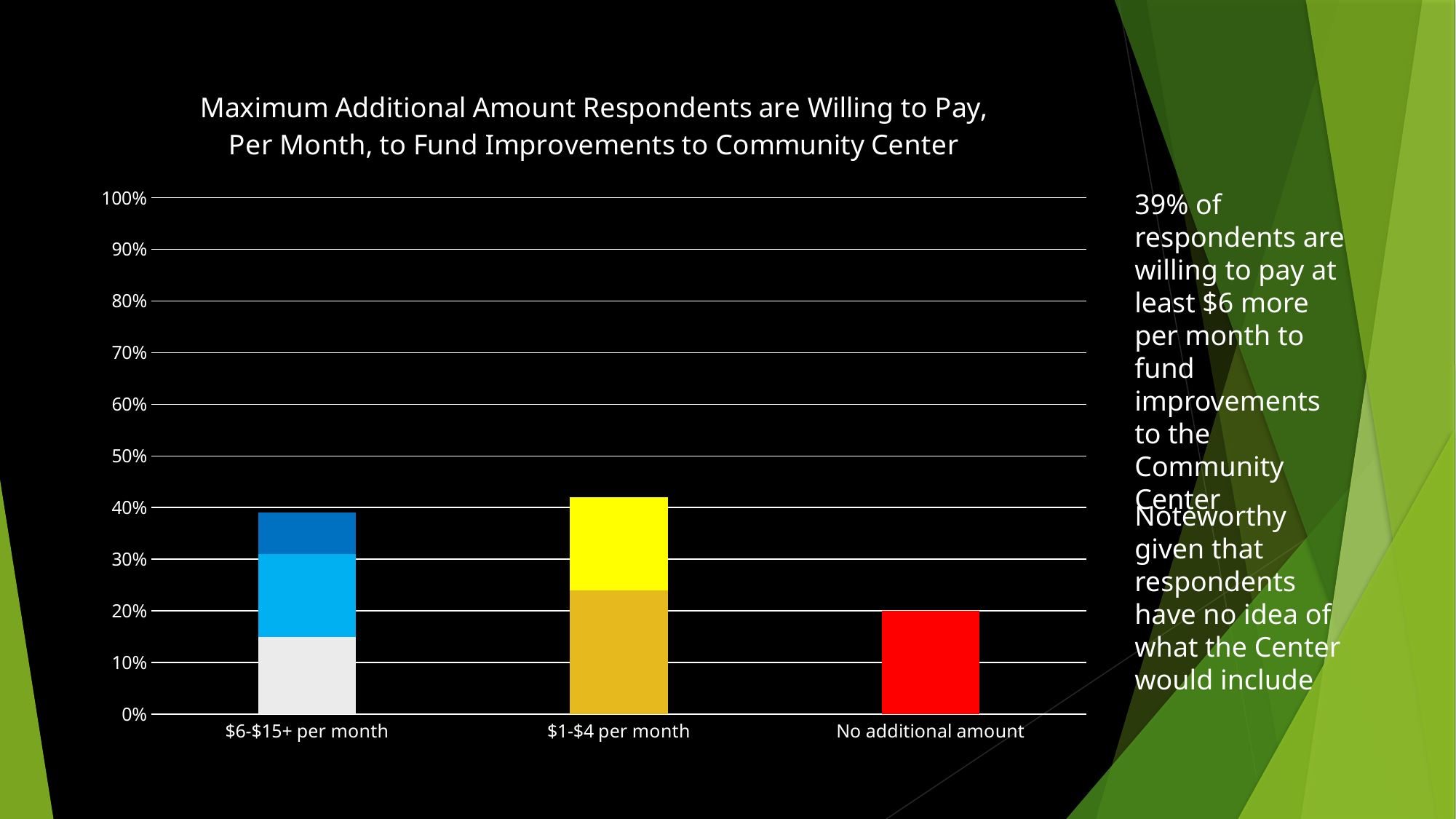
Which bar is taller: $6-$15+ per month or No additional amount? $6-$15+ per month Is the value for No additional amount greater or less than 30%? less Which bar is taller: $1-$4 per month or No additional amount? $1-$4 per month What colour is the bar for No additional amount? red What is the title of the chart? Maximum Additional Amount Respondents are Willing to Pay, Per Month, to Fund Improvements to Community Center How many categories are shown on the x axis of the chart? 3 What is the highest value shown on the y axis of the chart? 100% Which category has the shortest bar in the chart? No additional amount Which category has the tallest bar in the chart? $1-$4 per month What kind of chart is shown on the slide? bar chart Is the total value for $1-$4 per month greater or less than 40%? greater Is the total value for $6-$15+ per month greater or less than 40%? less